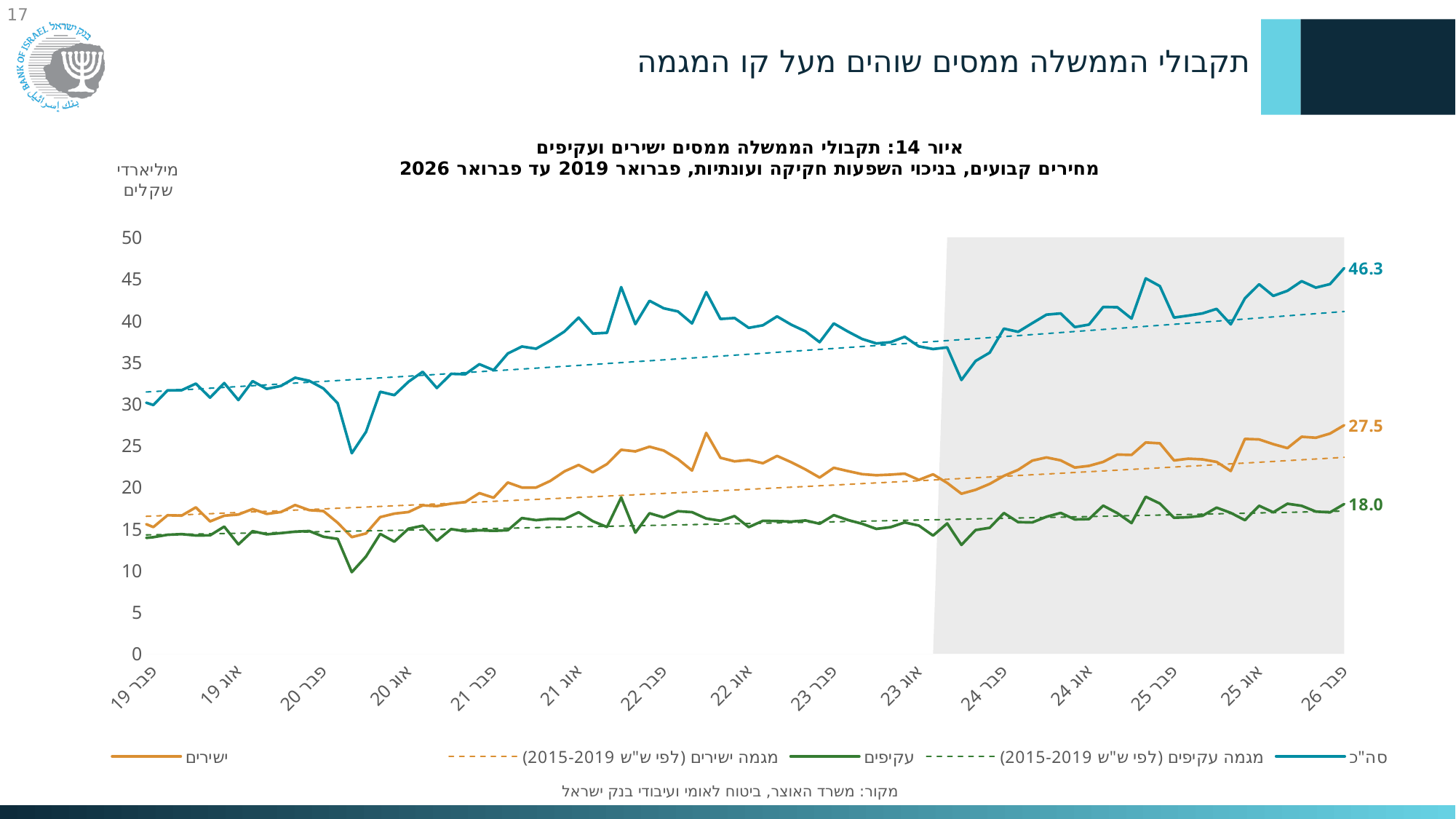
What is the difference between the סה"כ value and the ישירים value at פבר 26? 18.8 What is the value of the ישירים series at the end of the chart (פבר 26)? 27.5 At פבר 26, which is larger: the ישירים value or the עקיפים value? ישירים How many entries does the legend list? 5 What is the value of the סה"כ series at the end of the chart (פבר 26)? 46.3 Is the value of the ישירים series at פבר 19 greater or less than 20? less Does the סה"כ series generally rise or fall from פבר 19 to פבר 26? rise What is the difference between the ישירים value and the עקיפים value at פבר 26? 9.5 What kind of chart is shown on the slide? line chart Is the value of the סה"כ series at פבר 19 greater or less than 25? greater What is the value of the עקיפים series at the end of the chart (פבר 26)? 18.0 Which series has the highest value at פבר 26? סה"כ